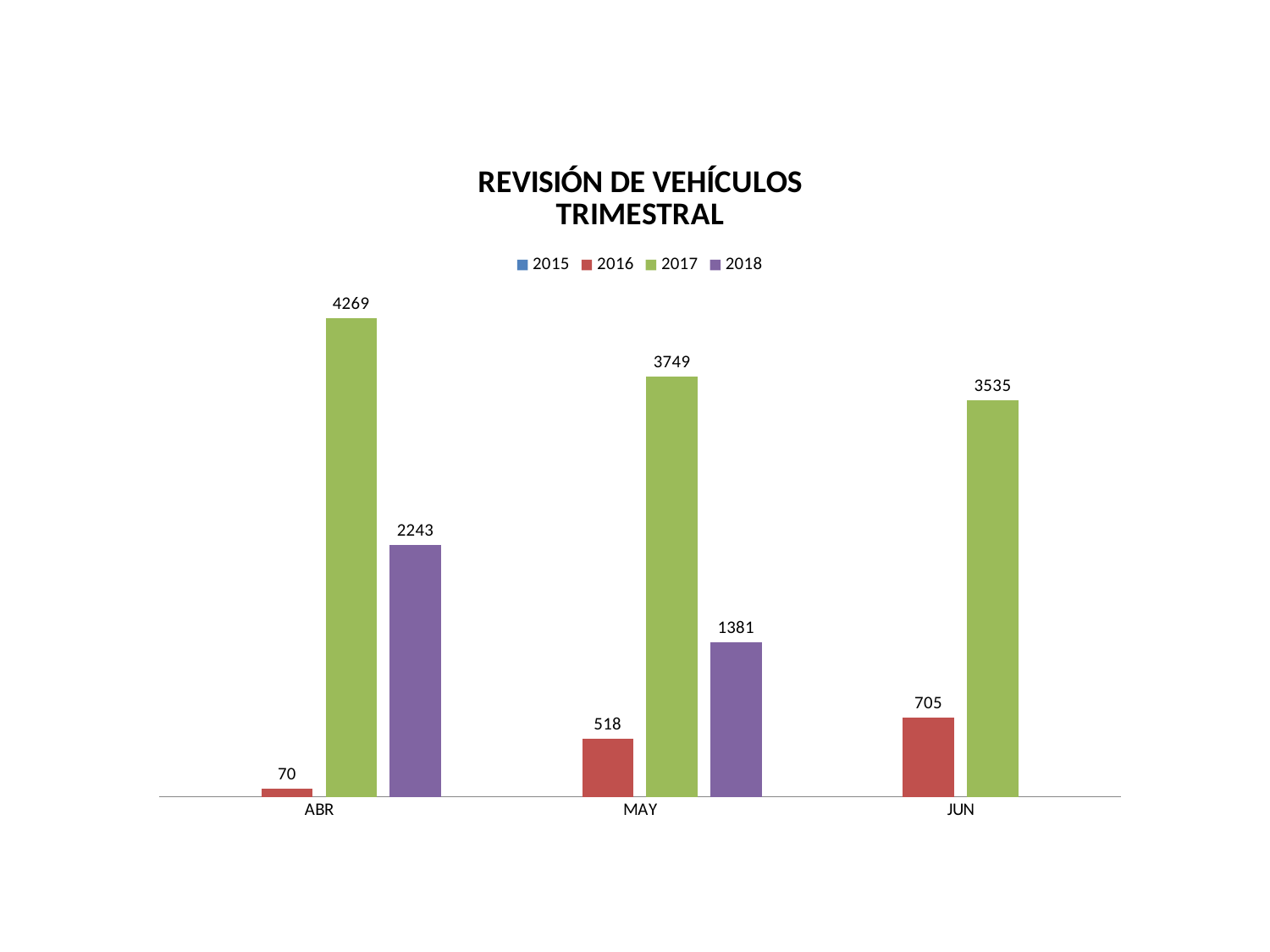
How many series does the legend list? 4 Which is larger, the 2016 value in MAY or the 2016 value in JUN? 2016 value in JUN What is the value for 2018 in MAY? 1381 Do the 2017 values rise or fall from ABR to JUN? Fall What is the difference between the 2017 and 2018 values in ABR? 2026 What kind of chart is this? Bar chart Which month has the highest value for 2017? ABR What is the title of the chart? REVISIÓN DE VEHÍCULOS TRIMESTRAL What is the value for 2017 in ABR? 4269 What is the value for 2016 in JUN? 705 Which month has the lowest value for 2016? ABR How many months are shown on the x axis? 3